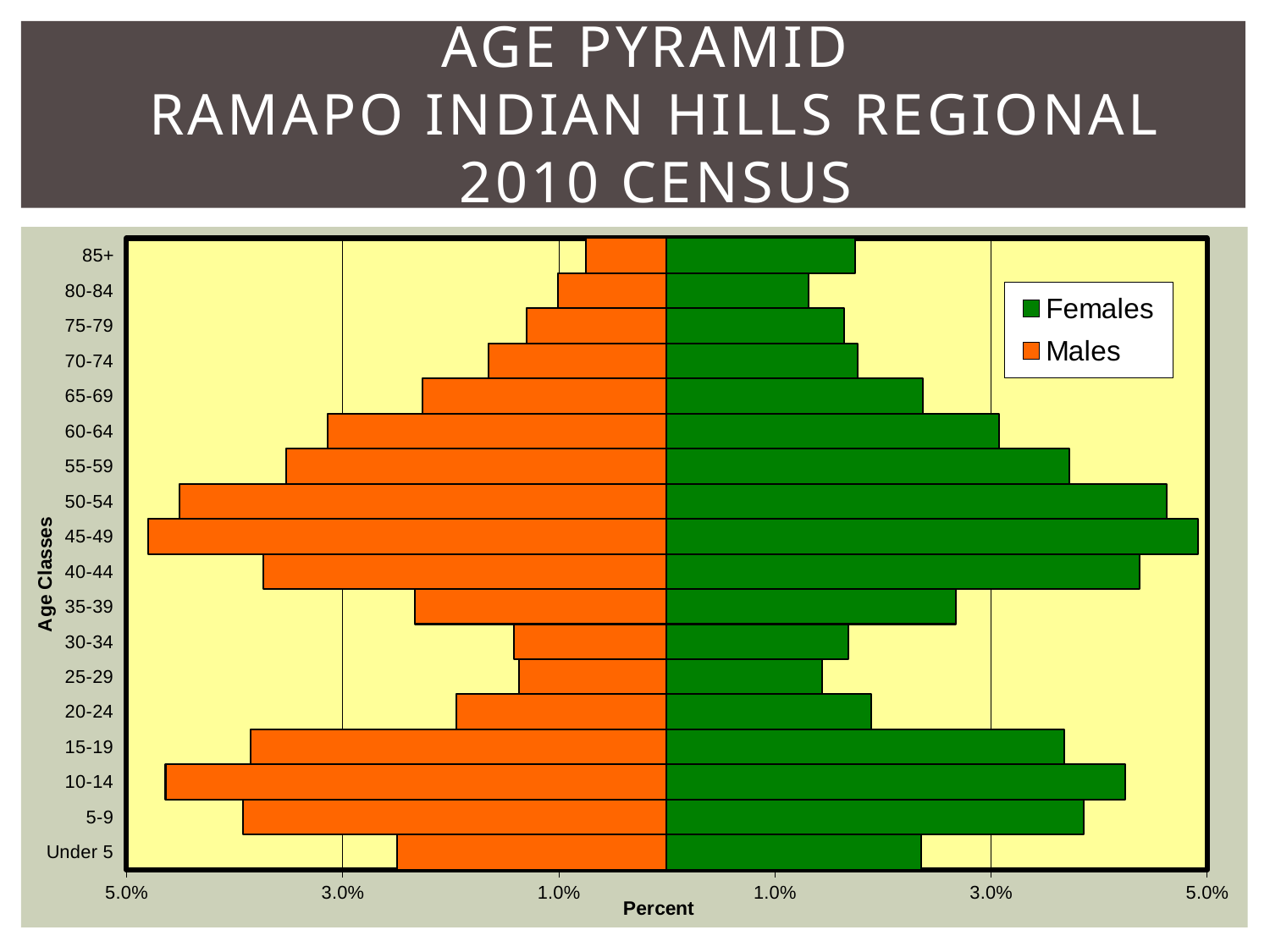
Which age class has the longest Males bar? 45-49 Which age class has the longest Females bar? 45-49 Is the Females value for the 50-54 age class greater or less than 3.0%? greater Which age class has the shortest Males bar? 85+ Is the Females value for the 35-39 age class greater or less than 3.0%? less Is the Males value for the 85+ age class greater or less than 1.0%? less Which is larger, the Males value for 10-14 or the Males value for 15-19? 10-14 What colour represents Females in the chart? Green How many age classes are plotted on the y axis? 18 How many series does the legend list? 2 What kind of chart is shown on the slide? Bar chart